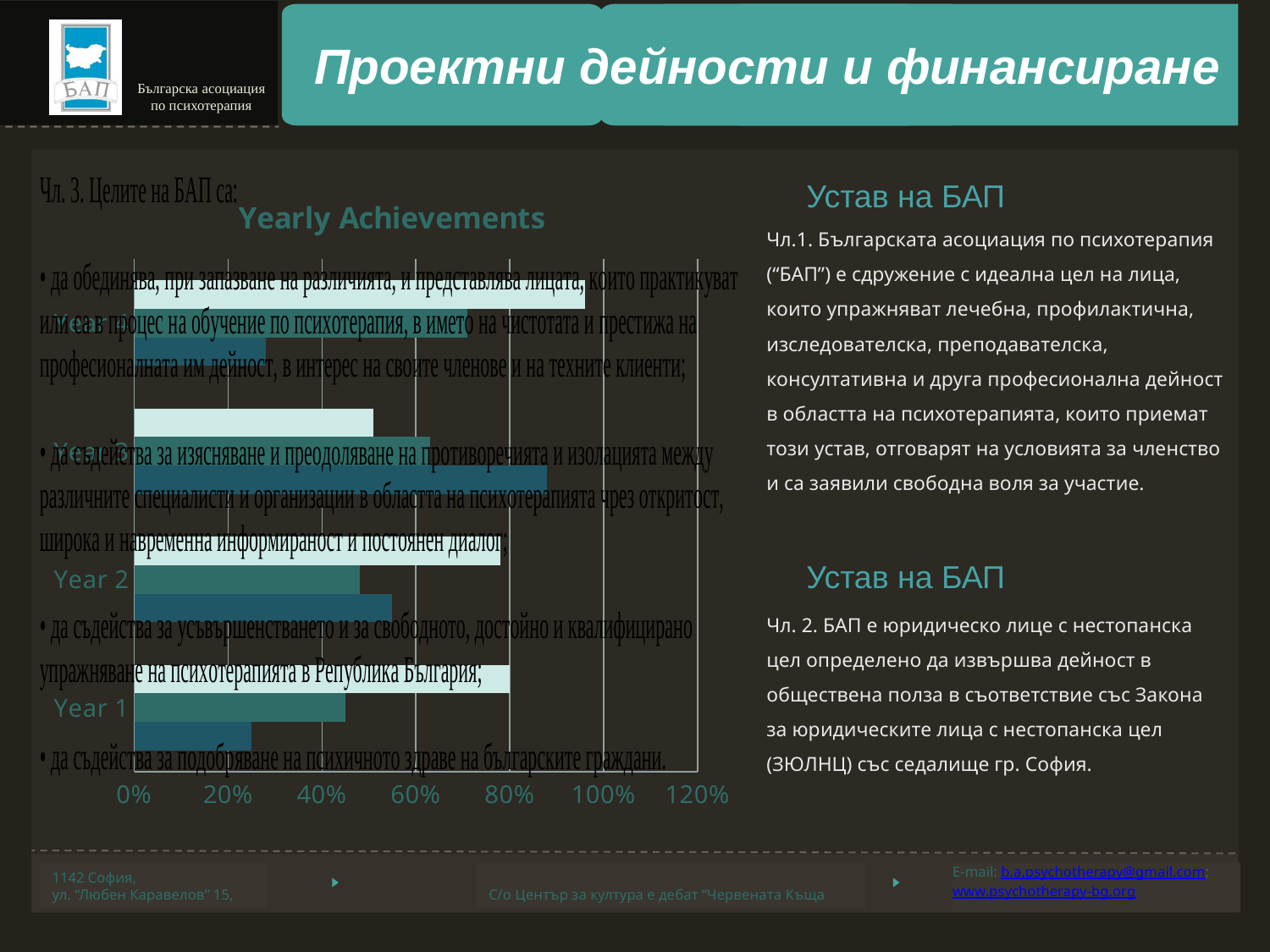
In the Year 2 group, which is larger: the top bar or the middle bar? top bar Is the value of the topmost (lightest) bar in the Year 2 group greater or less than 60%? greater Within the Year 1 group, which bar is the longest: the top, middle or bottom bar? top Within the Year 1 group, which bar is the shortest: the top, middle or bottom bar? bottom What is the highest value shown on the chart's horizontal axis? 120% What is the title of the chart on the slide? Yearly Achievements Is the value of the middle bar in the Year 2 group greater or less than 60%? less How many bars are plotted in the Year 1 group of the chart? 3 What type of chart is shown on the slide? bar chart Is the value of the bottom (darkest) bar in the Year 1 group greater or less than 40%? less How many groups of bars does the chart contain? 4